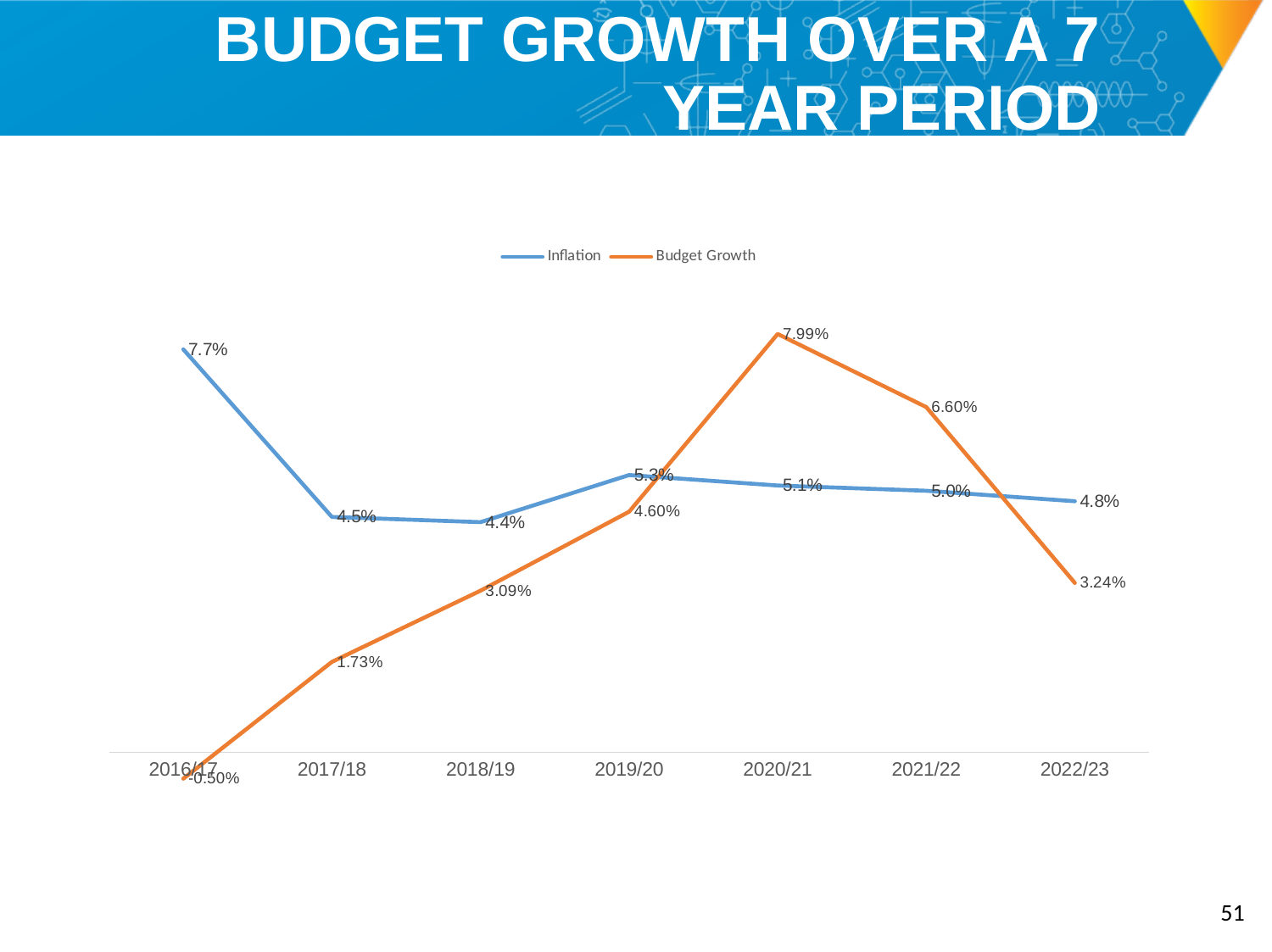
What type of chart is shown on the slide? line chart What is the Inflation value for 2016/17? 7.7% What is the difference between Budget Growth and Inflation in 2022/23? 1.56% How many series does the legend list? 2 Which is larger in 2021/22, Inflation or Budget Growth? Budget Growth What is the Budget Growth value for 2020/21? 7.99% How many years are plotted along the x axis? 7 In which year is Budget Growth highest? 2020/21 In which year is Inflation lowest? 2018/19 Does Budget Growth rise or fall from 2016/17 to 2020/21? rise What is the Budget Growth value for 2016/17? -0.50% Which colour is used for the Budget Growth line? orange